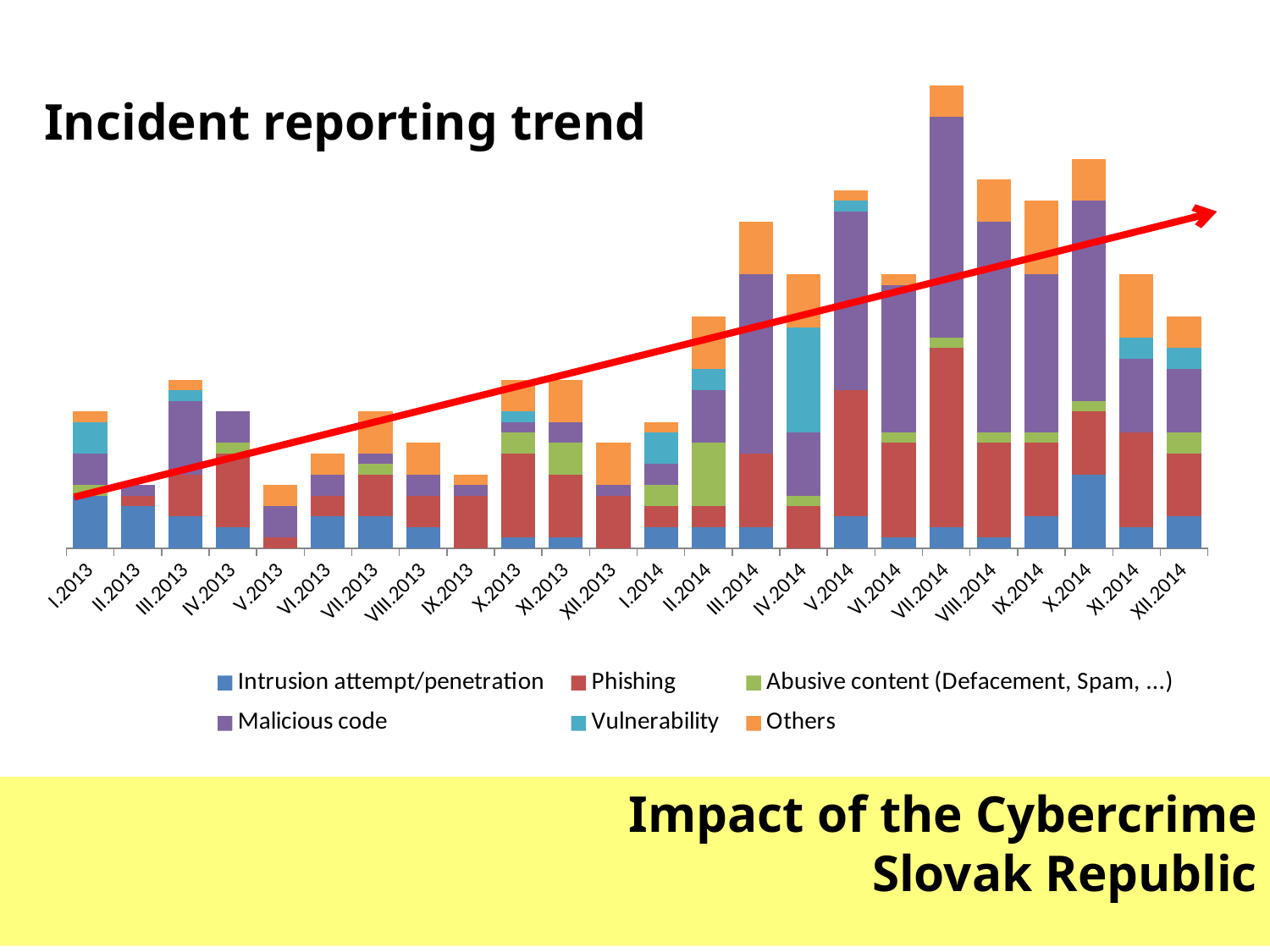
Do the incident totals generally rise or fall from I.2013 to XII.2014? Rise How many series does the legend list? 6 What kind of chart is shown on the slide? Stacked bar chart Which series is shown in red in the legend? Phishing Which bar is taller, III.2014 or IV.2014? III.2014 Which bar is taller, X.2014 or XII.2014? X.2014 Which month has the tallest stacked bar? VII.2014 Is the total bar for VII.2014 taller or shorter than the bar for I.2013? Taller What is the title of the chart? Incident reporting trend How many months (categories) are shown on the x axis? 24